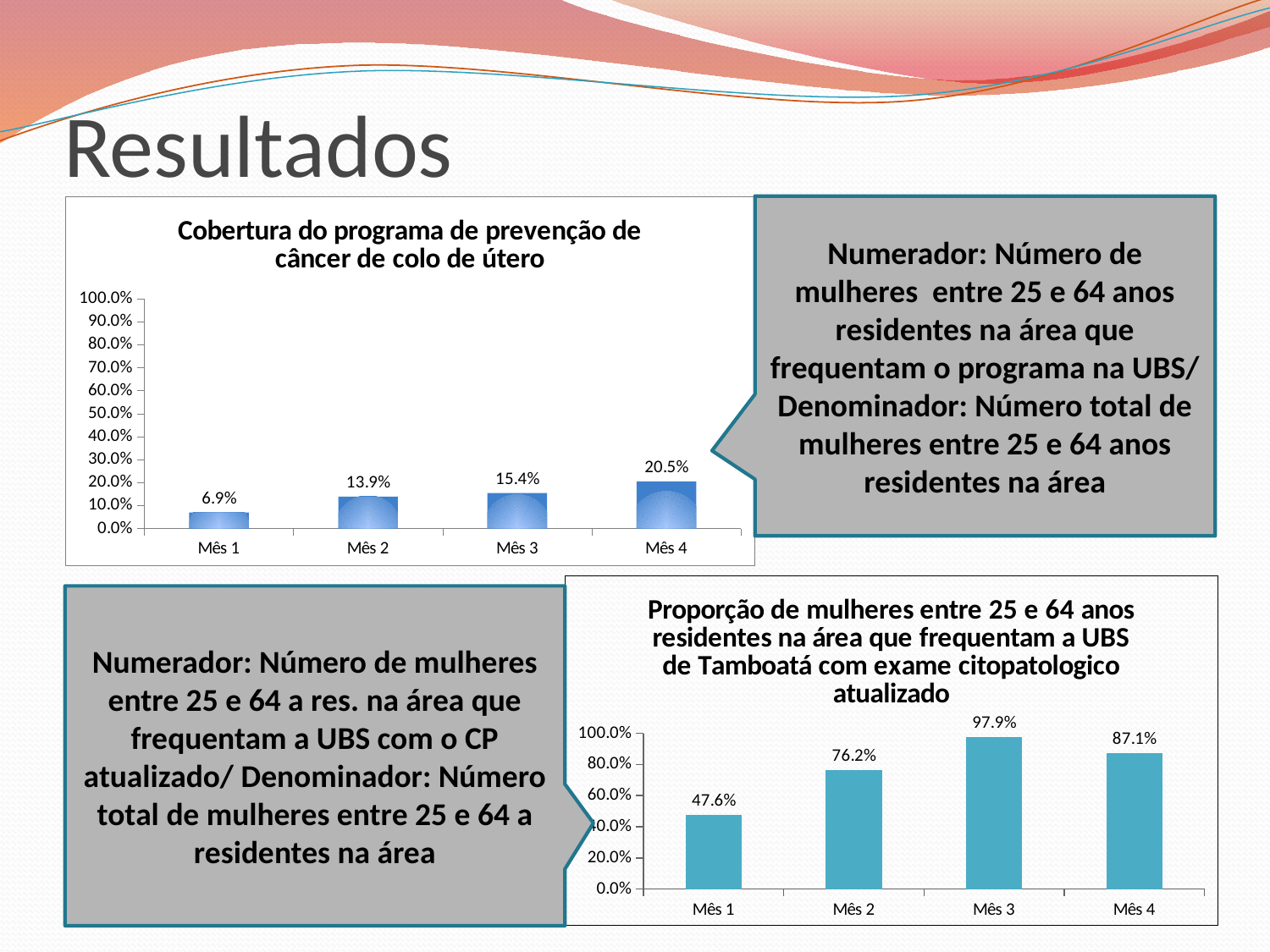
In the top chart (Cobertura do programa de prevenção de câncer de colo de útero), how many months are plotted? 4 In the bottom chart (Proporção de mulheres entre 25 e 64 anos ... com exame citopatologico atualizado), which is larger, Mês 3 or Mês 4? Mês 3 In the top chart (Cobertura do programa de prevenção de câncer de colo de útero), do the values rise or fall from Mês 1 to Mês 4? rise In the bottom chart (Proporção de mulheres entre 25 e 64 anos ... com exame citopatologico atualizado), is the value for Mês 1 greater or less than 60.0%? less In the bottom chart (Proporção de mulheres entre 25 e 64 anos ... com exame citopatologico atualizado), which month has the highest value? Mês 3 In the top chart (Cobertura do programa de prevenção de câncer de colo de útero), what is the value for Mês 4? 20.5% In the top chart (Cobertura do programa de prevenção de câncer de colo de útero), what is the value for Mês 1? 6.9% In the top chart (Cobertura do programa de prevenção de câncer de colo de útero), which month has the lowest value? Mês 1 In the top chart (Cobertura do programa de prevenção de câncer de colo de útero), what is the difference between Mês 4 and Mês 3? 5.1% In the bottom chart (Proporção de mulheres entre 25 e 64 anos ... com exame citopatologico atualizado), what is the value for Mês 2? 76.2% In the bottom chart (Proporção de mulheres entre 25 e 64 anos ... com exame citopatologico atualizado), what is the difference between Mês 2 and Mês 1? 28.6% What kind of chart is the bottom chart on the slide? bar chart